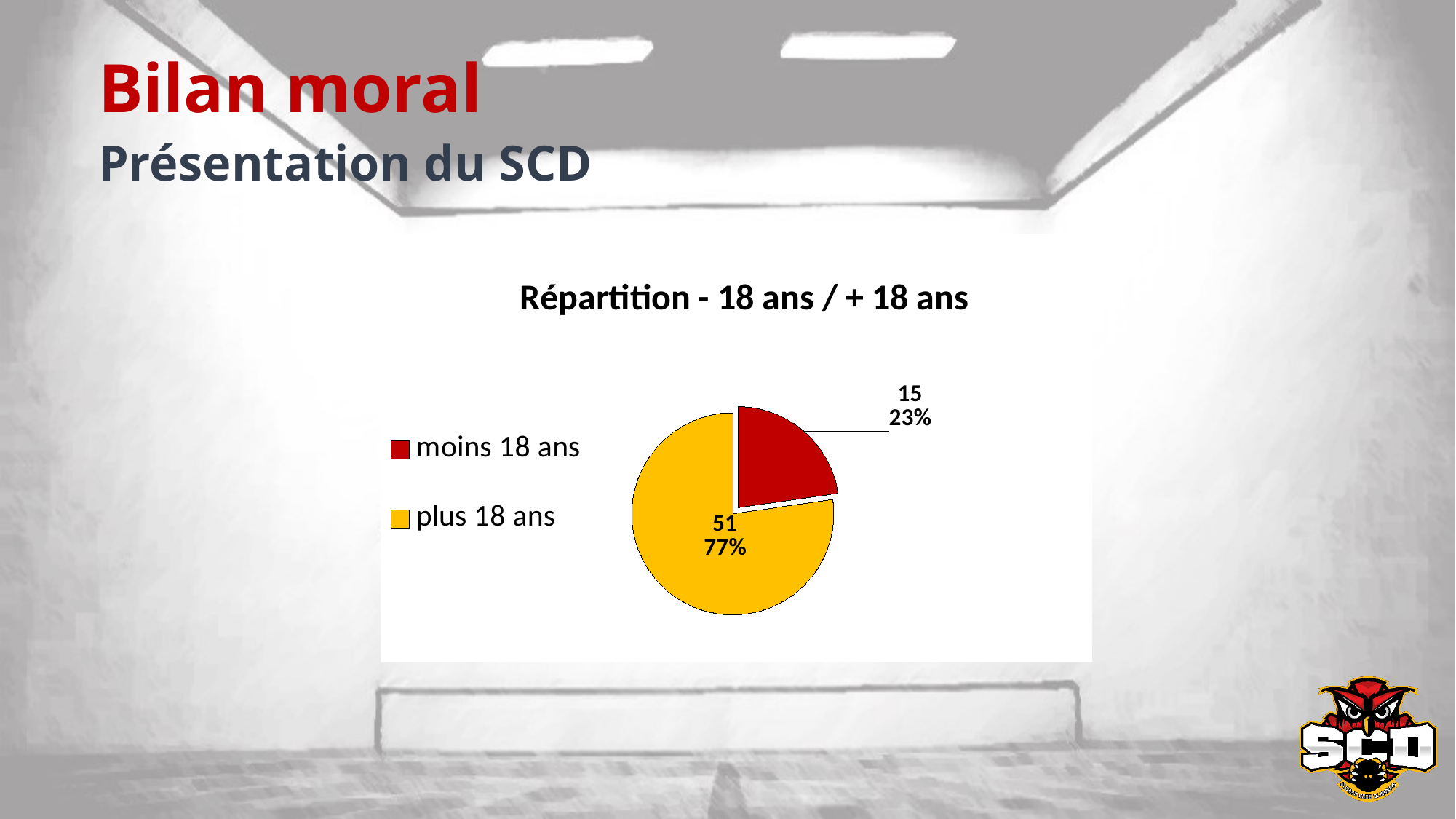
Which category has the smallest slice? moins 18 ans What is the value for "moins 18 ans"? 15 What colour is the slice for "moins 18 ans"? red How many categories does the pie chart have? 2 What is the value for "plus 18 ans"? 51 What is the difference between the values for "plus 18 ans" and "moins 18 ans"? 36 What kind of chart is shown on the slide? pie chart Which category has the largest slice? plus 18 ans What is the title of the chart? Répartition - 18 ans / + 18 ans Which is larger, the value for "moins 18 ans" or "plus 18 ans"? plus 18 ans What share of the pie does "plus 18 ans" represent? 77% What share of the pie does "moins 18 ans" represent? 23%